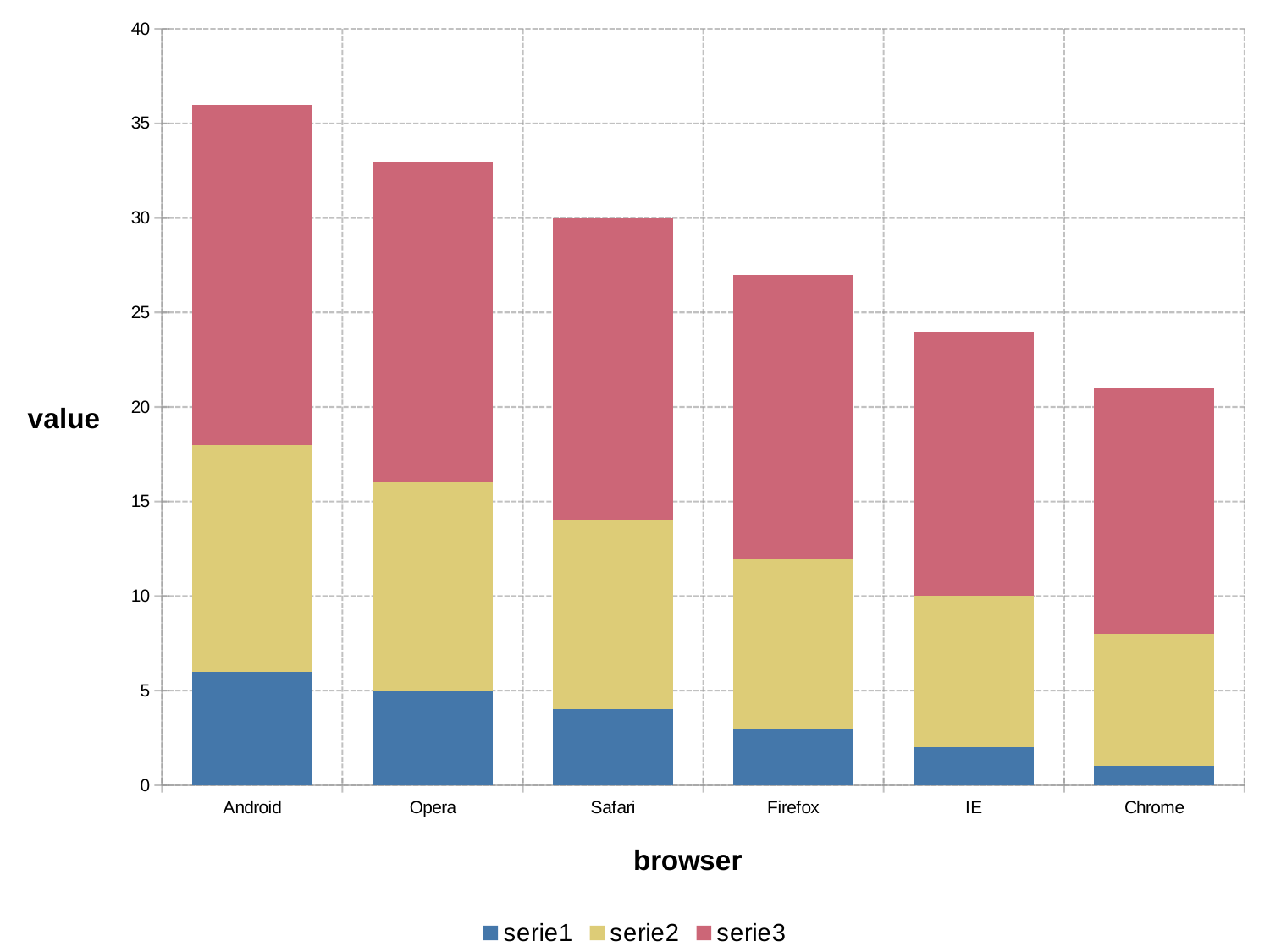
What is the total height of the stacked bar for Safari? 30 Which browser has the shortest stacked bar? Chrome How many series does the legend list? 3 Which is larger, the total stacked bar for Firefox or for IE? Firefox Do the total bar heights rise or fall from Android to Chrome along the x axis? fall What kind of chart is shown on the slide? stacked bar chart How many browsers are shown on the x axis? 6 What is the serie1 value for Opera? 5 Is the total stacked bar for Android greater or less than 35? greater Is the total stacked bar for Chrome greater or less than 25? less Which browser has the tallest stacked bar? Android What is the label of the y axis? value